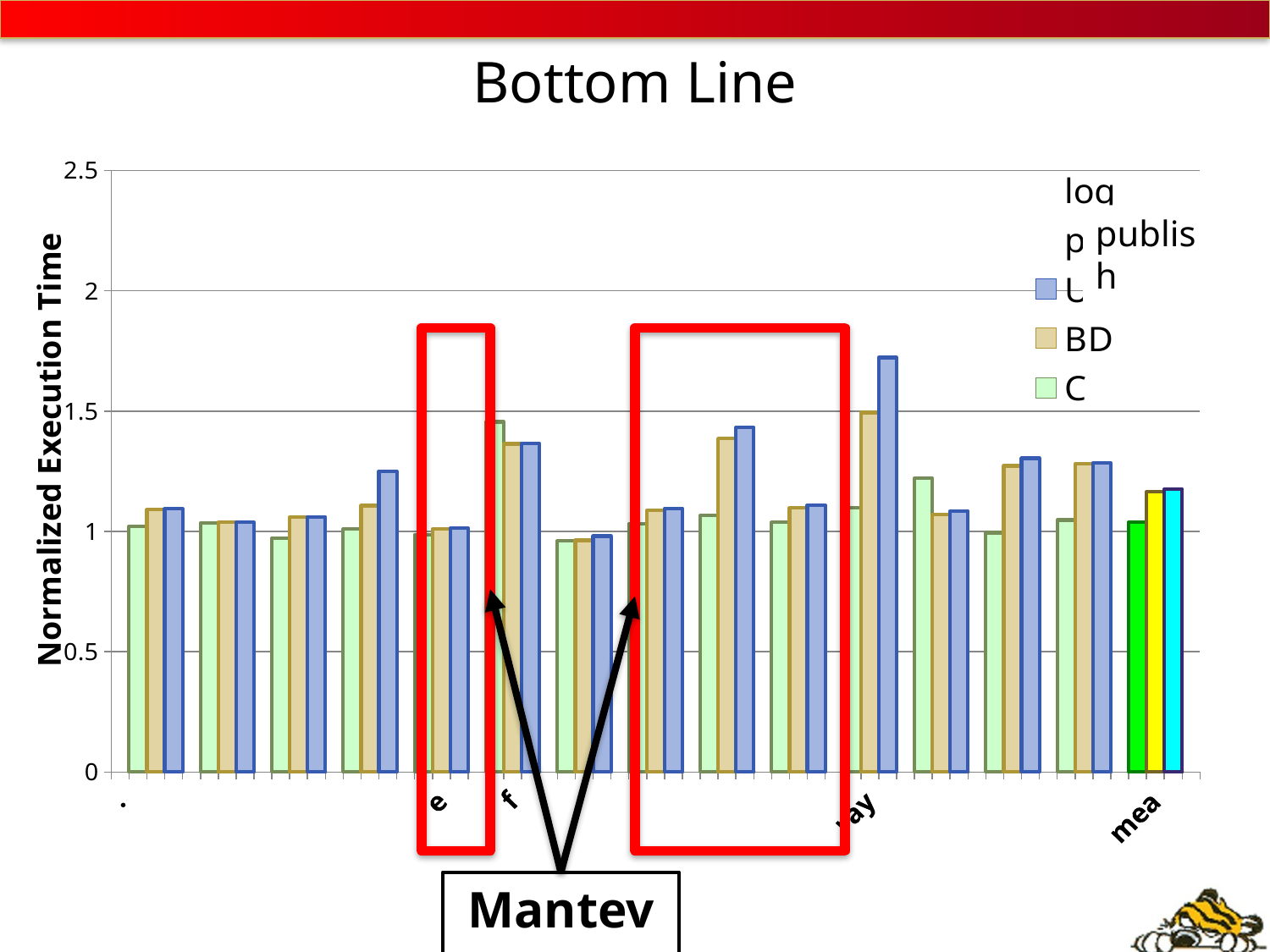
Is the tallest bar on the chart greater or less than 2? less What is the label on the vertical axis? Normalized Execution Time What kind of chart is shown on the slide? bar chart What is the title of the chart? Bottom Line Is the tallest bar on the chart greater or less than 1.5? greater How many groups of bars are plotted along the x axis? 15 What is the highest value shown on the vertical axis? 2.5